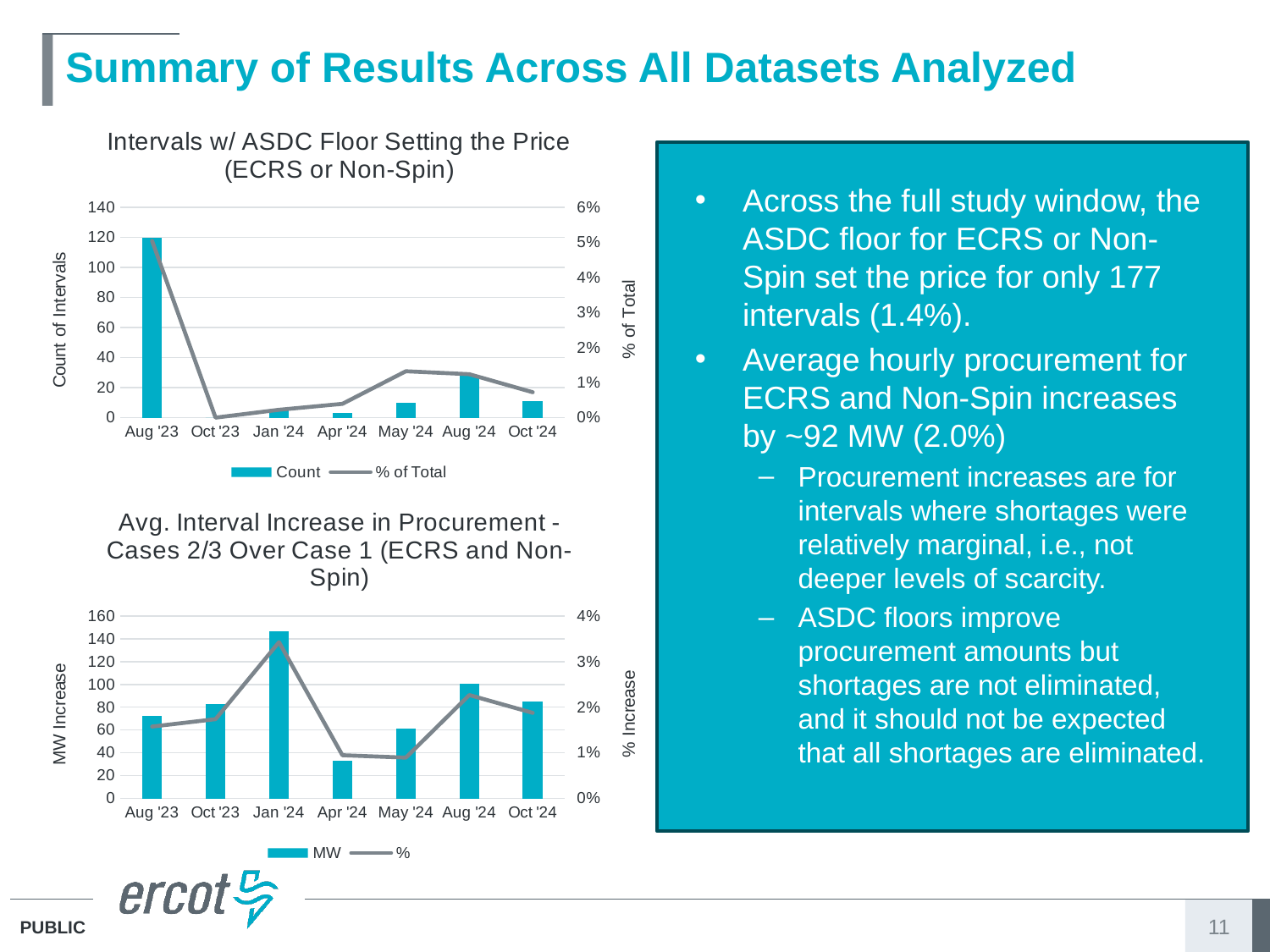
In the chart 'Intervals w/ ASDC Floor Setting the Price (ECRS or Non-Spin)', which month has the highest Count of Intervals? Aug '23 In the chart 'Avg. Interval Increase in Procurement - Cases 2/3 Over Case 1 (ECRS and Non-Spin)', is the MW value for Jan '24 greater or less than 140? greater In the chart 'Avg. Interval Increase in Procurement - Cases 2/3 Over Case 1 (ECRS and Non-Spin)', which has the larger MW Increase, May '24 or Aug '24? Aug '24 In the chart 'Avg. Interval Increase in Procurement - Cases 2/3 Over Case 1 (ECRS and Non-Spin)', which month has the highest MW Increase? Jan '24 In the chart 'Avg. Interval Increase in Procurement - Cases 2/3 Over Case 1 (ECRS and Non-Spin)', is the MW value for Apr '24 greater or less than 40? less In the chart 'Intervals w/ ASDC Floor Setting the Price (ECRS or Non-Spin)', is the Count for Aug '24 greater or less than 20? greater What are the two legend entries in the chart 'Avg. Interval Increase in Procurement - Cases 2/3 Over Case 1 (ECRS and Non-Spin)'? MW and % How many months are shown on the x axis of the chart 'Intervals w/ ASDC Floor Setting the Price (ECRS or Non-Spin)'? 7 How many series does the legend of the chart 'Intervals w/ ASDC Floor Setting the Price (ECRS or Non-Spin)' list? 2 In the chart 'Avg. Interval Increase in Procurement - Cases 2/3 Over Case 1 (ECRS and Non-Spin)', which month has the lowest MW Increase? Apr '24 What kind of chart is 'Intervals w/ ASDC Floor Setting the Price (ECRS or Non-Spin)'? Combined bar and line chart